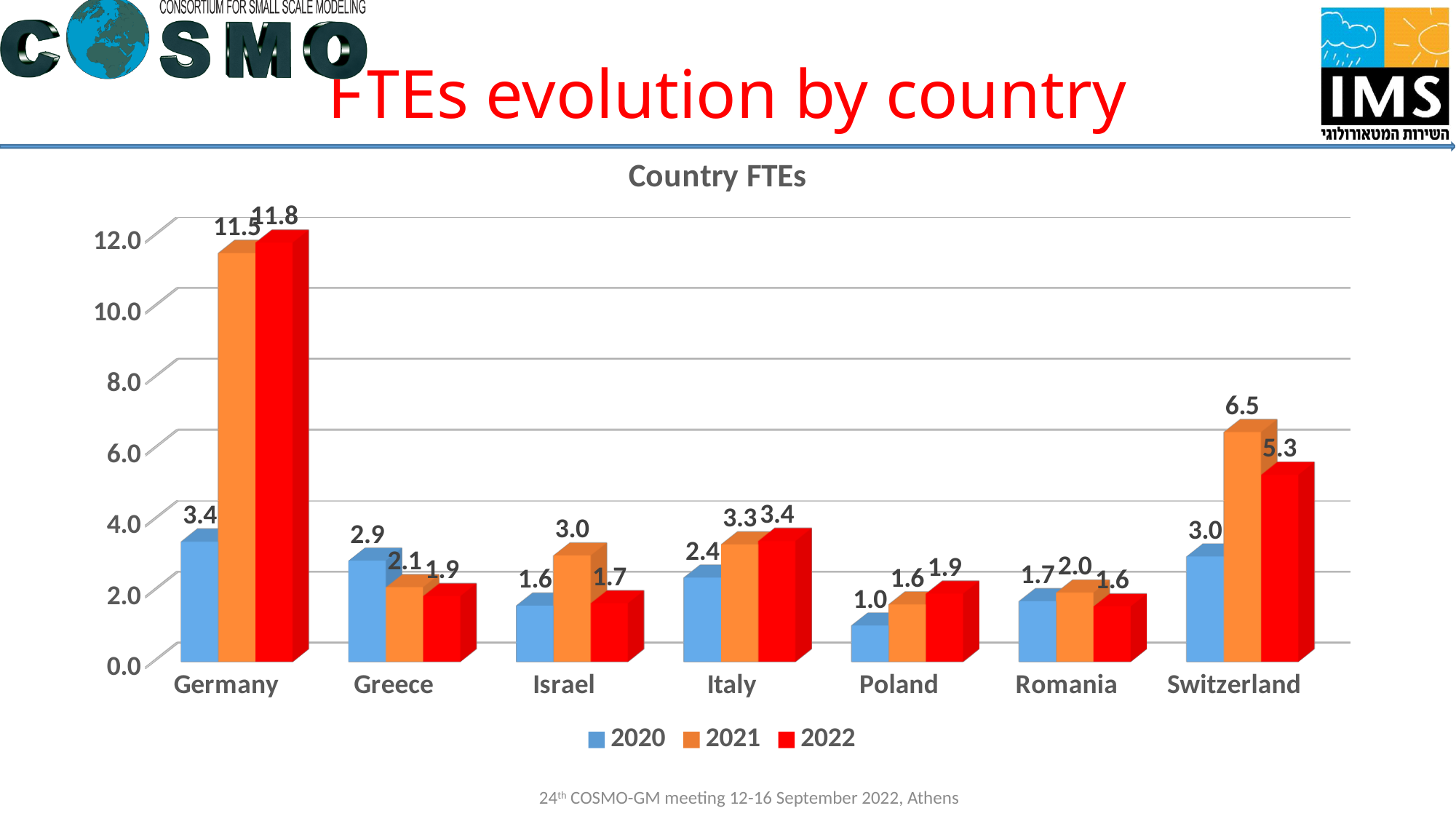
How many series does the legend list? 3 What is the 2022 value for Switzerland? 5.3 Do the values for Poland rise or fall from 2020 to 2022? Rise Which is larger for Israel, the 2021 value or the 2022 value? 2021 What is the difference between the 2021 and 2020 values for Switzerland? 3.5 Which country has the highest 2022 value? Germany What kind of chart is shown? Bar chart What is the title of the chart? Country FTEs How many countries are shown on the x axis? 7 Which country has the lowest 2020 value? Poland What is the 2020 value for Poland? 1.0 What is the 2021 value for Germany? 11.5